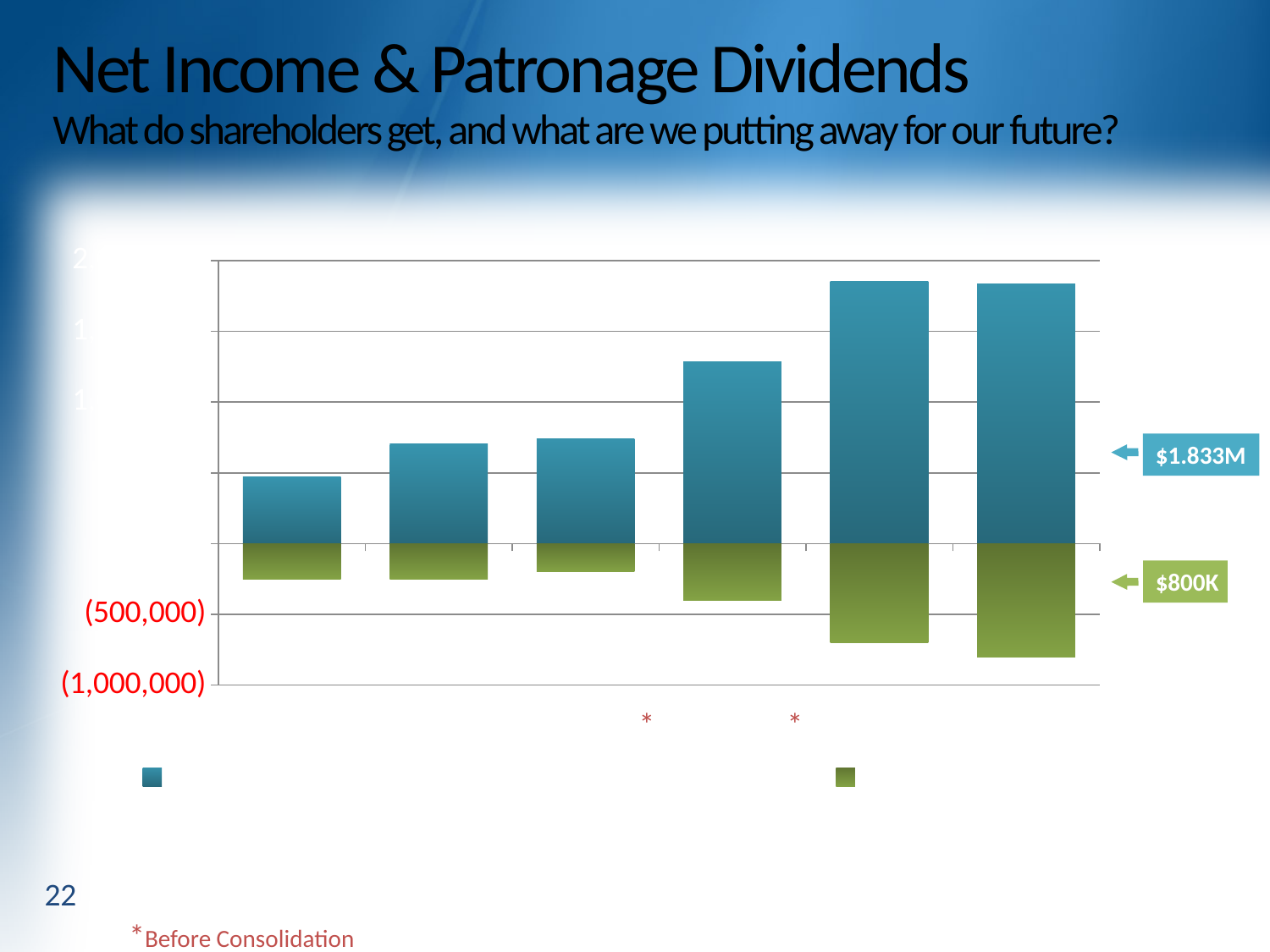
Is the green (negative) value of the leftmost bar greater or less than (500,000)? greater Which is larger, the blue (positive) value of the fourth bar from the left or the blue value of the third bar from the left? the fourth bar How many series does the chart's legend show? 2 What is the title of the slide containing the chart? Net Income & Patronage Dividends What value does the callout pointing at the green (negative) part of the rightmost bar show? $800K Which bar has the smallest blue (positive) value? the leftmost bar What does the asterisk footnote below the chart say? Before Consolidation Do the blue (positive) values generally rise or fall from left to right across the chart? rise What value does the callout pointing at the blue (positive) part of the rightmost bar show? $1.833M How many bars (categories) are plotted along the x axis of the chart? 6 Is the green (negative) value of the rightmost bar greater or less than (500,000)? less What kind of chart is shown on the slide? bar chart